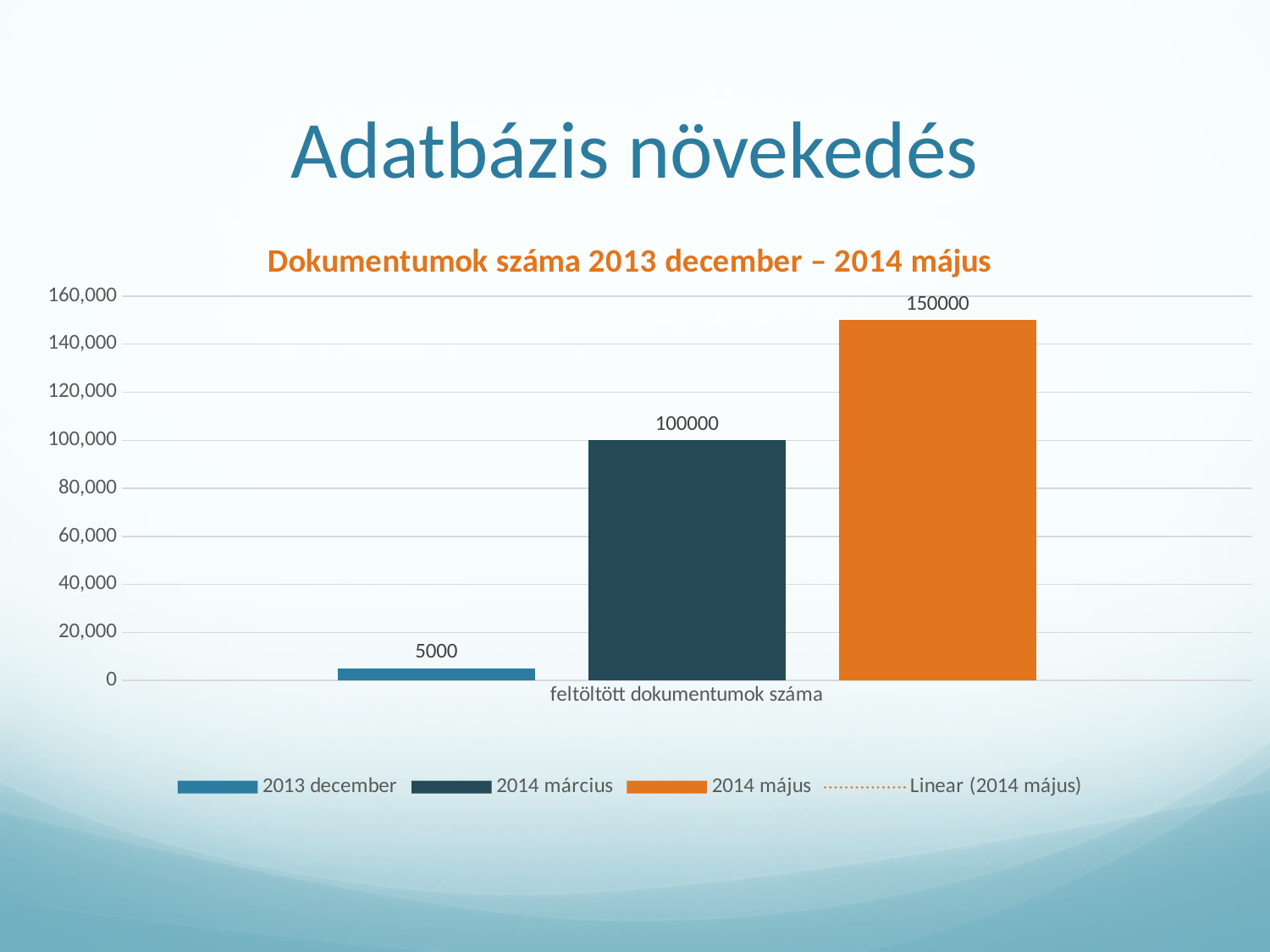
What is the title of the chart? Dokumentumok száma 2013 december – 2014 május What is the difference between the values for 2014 május and 2014 március? 50000 Is the value for 2014 május greater or less than 140,000? greater Which is larger, the value for 2014 március or the value for 2013 december? 2014 március What is the value for 2014 március? 100000 Which series has the highest value? 2014 május What is the value for 2013 december? 5000 What is the value for 2014 május? 150000 Which series has the lowest value? 2013 december What kind of chart is shown on the slide? bar chart What is the difference between the values for 2014 március and 2013 december? 95000 How many bars are plotted in the chart? 3